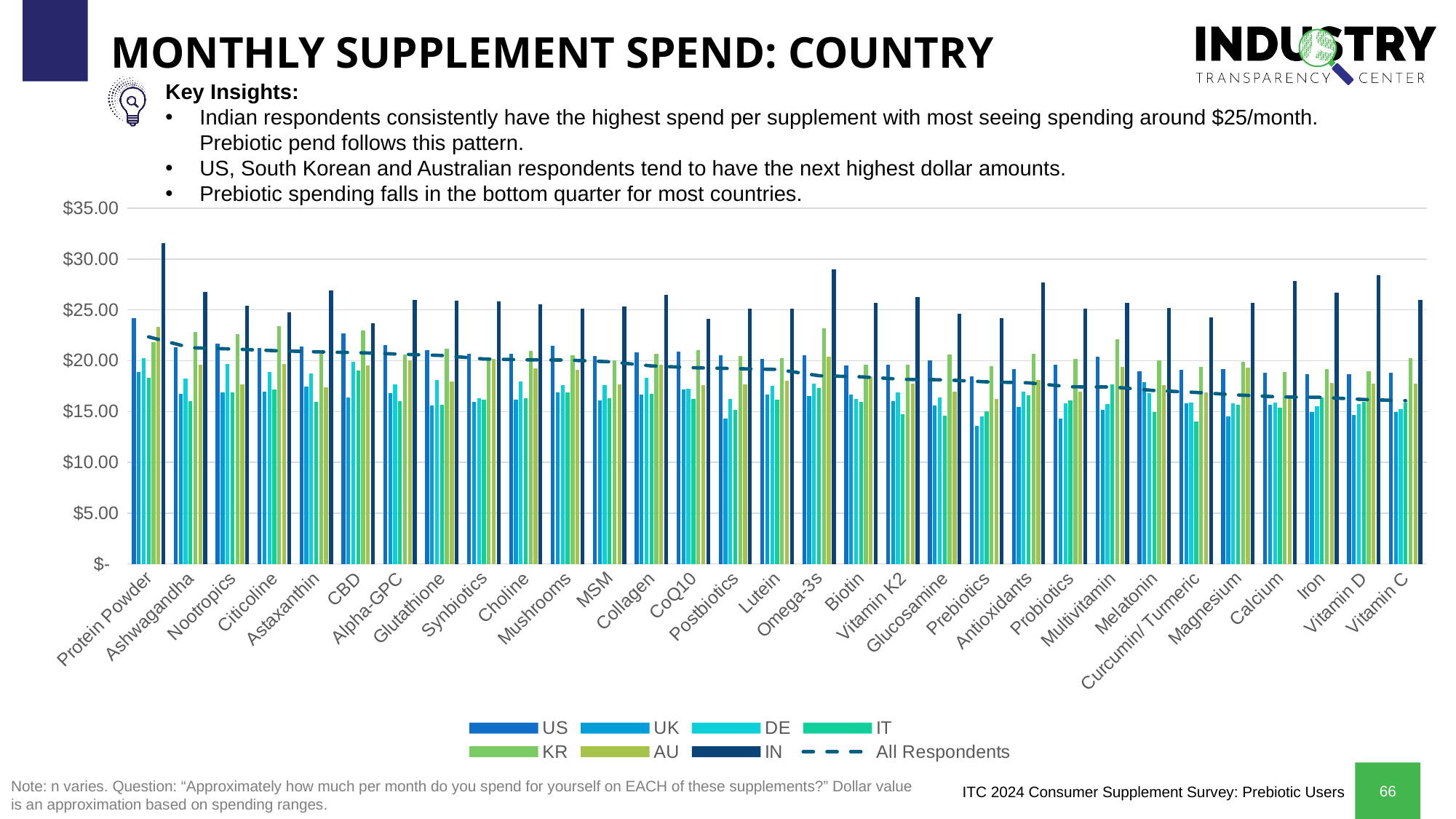
How many supplement categories are shown along the x axis? 31 Does the All Respondents dashed line generally rise or fall from Protein Powder to Vitamin C? fall Is the US value for Prebiotics greater or less than $15.00? greater Which country series has the highest bar for Protein Powder? IN Is the US value for Protein Powder greater or less than $25.00? less Is the US value for Vitamin C greater or less than $20.00? less How many entries does the legend list? 8 What kind of chart is shown on the slide? combination bar and line chart Which series is drawn as a dashed line rather than bars? All Respondents What is the title of the slide containing the chart? MONTHLY SUPPLEMENT SPEND: COUNTRY